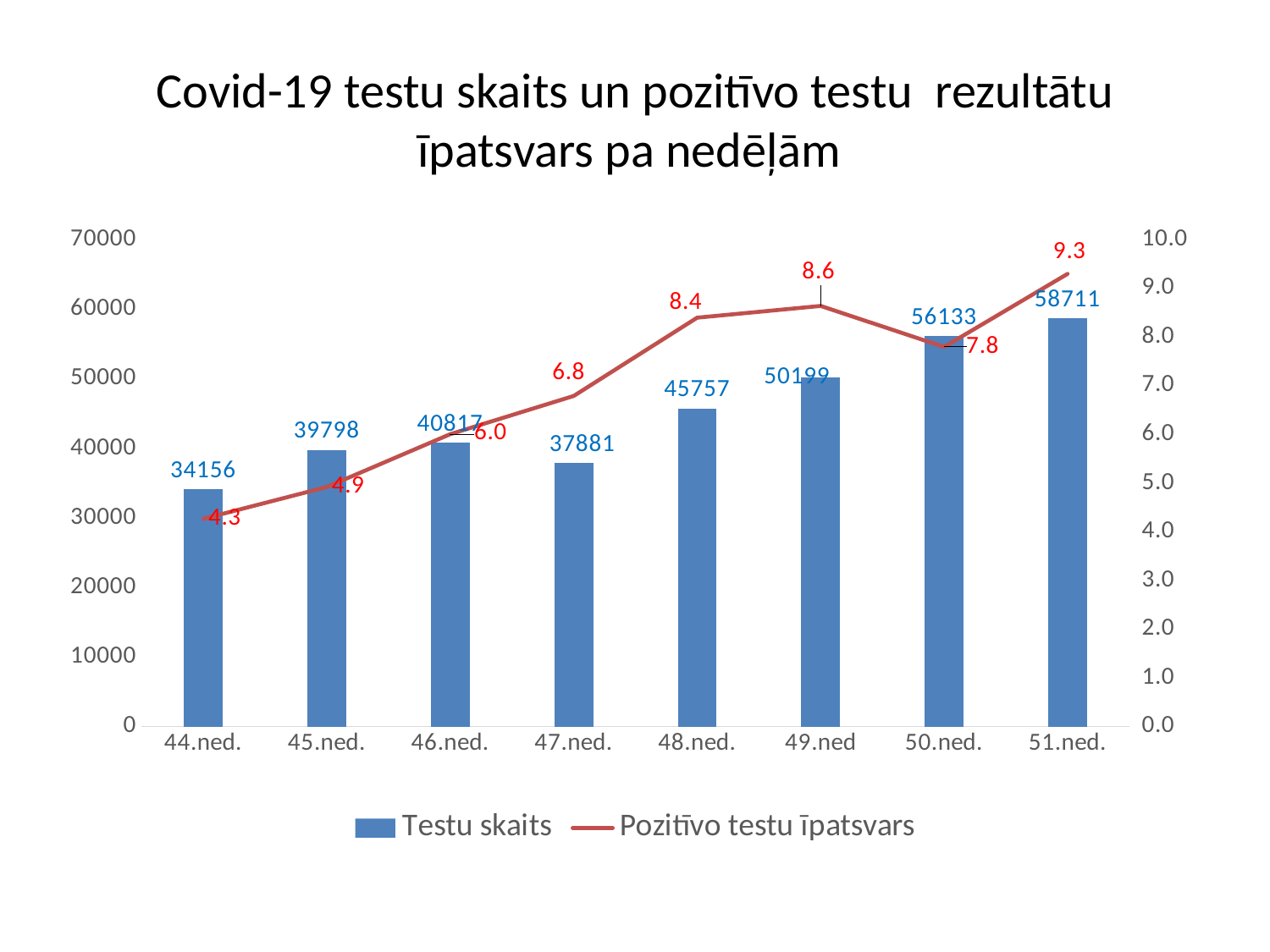
What is the value of Testu skaits for 44.ned.? 34156 Which is larger, the Testu skaits for 46.ned. or for 47.ned.? 46.ned. Which week has the highest Testu skaits? 51.ned. How many series does the legend list? 2 What is the value of Pozitīvo testu īpatsvars for 48.ned.? 8.4 What kind of chart is used for the Testu skaits series? bar chart What is the difference in Testu skaits between 51.ned. and 50.ned.? 2578 Does the Pozitīvo testu īpatsvars rise or fall from 44.ned. to 49.ned? rise How many weeks are shown on the x axis? 8 Which week has the lowest Pozitīvo testu īpatsvars? 44.ned. What is the value of Testu skaits for 50.ned.? 56133 Is the Testu skaits for 49.ned greater or less than 40000? greater